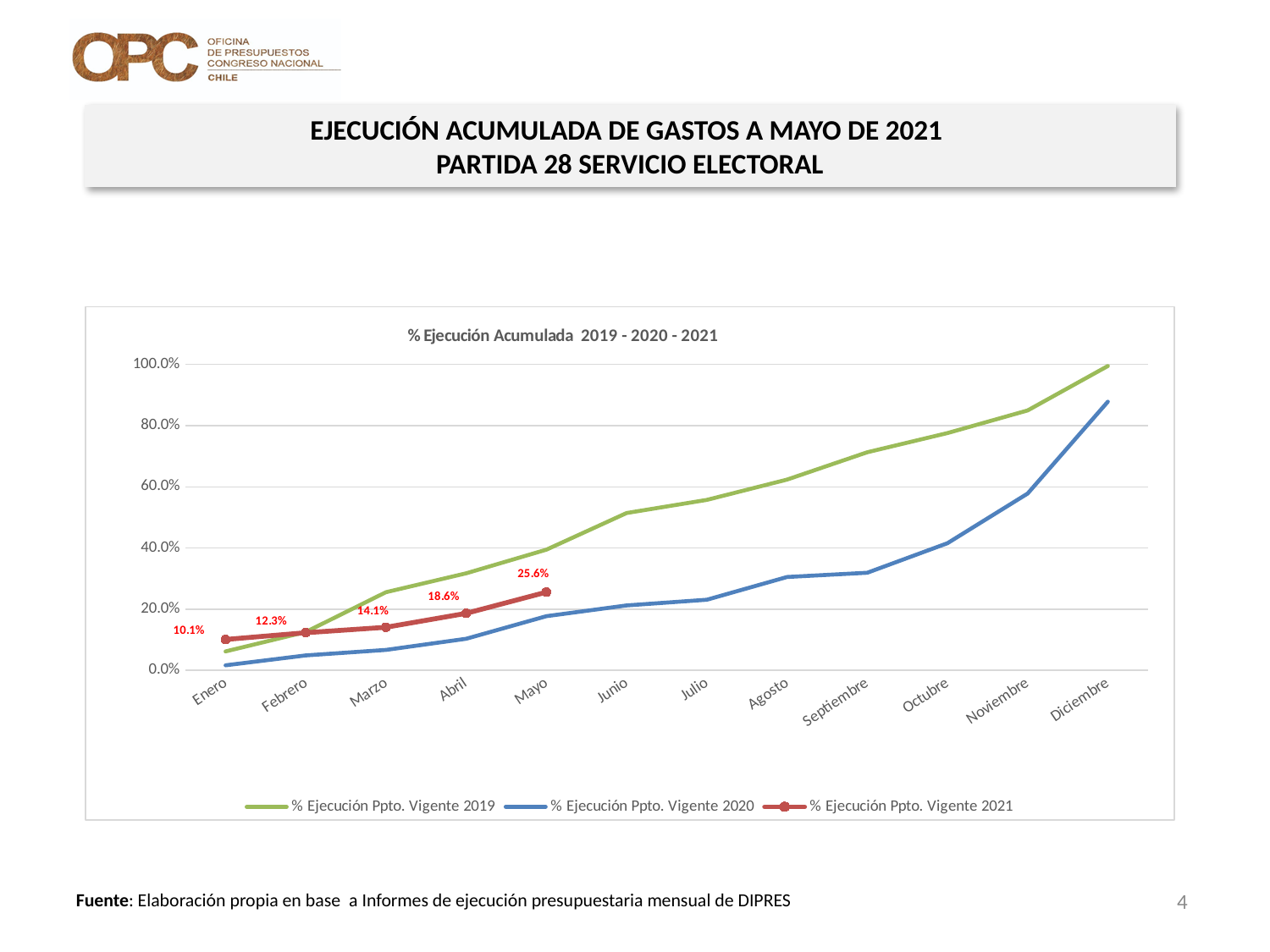
What is the value for % Ejecución Ppto. Vigente 2021 in Mayo? 25.6% How many series does the legend list? 3 What is the value for % Ejecución Ppto. Vigente 2021 in Marzo? 14.1% What is the value for % Ejecución Ppto. Vigente 2021 in Abril? 18.6% What is the difference between the 2021 values for Febrero and Enero? 2.2% What is the value for % Ejecución Ppto. Vigente 2021 in Enero? 10.1% How many months are shown on the x axis? 12 What is the difference between the 2021 values for Mayo and Abril? 7.0% Is the value for % Ejecución Ppto. Vigente 2019 in Diciembre greater or less than 80%? greater What kind of chart is shown on the slide? Line chart Does the % Ejecución Ppto. Vigente 2021 line rise or fall from Enero to Mayo? Rises In Mayo, which series has the higher value, % Ejecución Ppto. Vigente 2019 or % Ejecución Ppto. Vigente 2021? % Ejecución Ppto. Vigente 2019